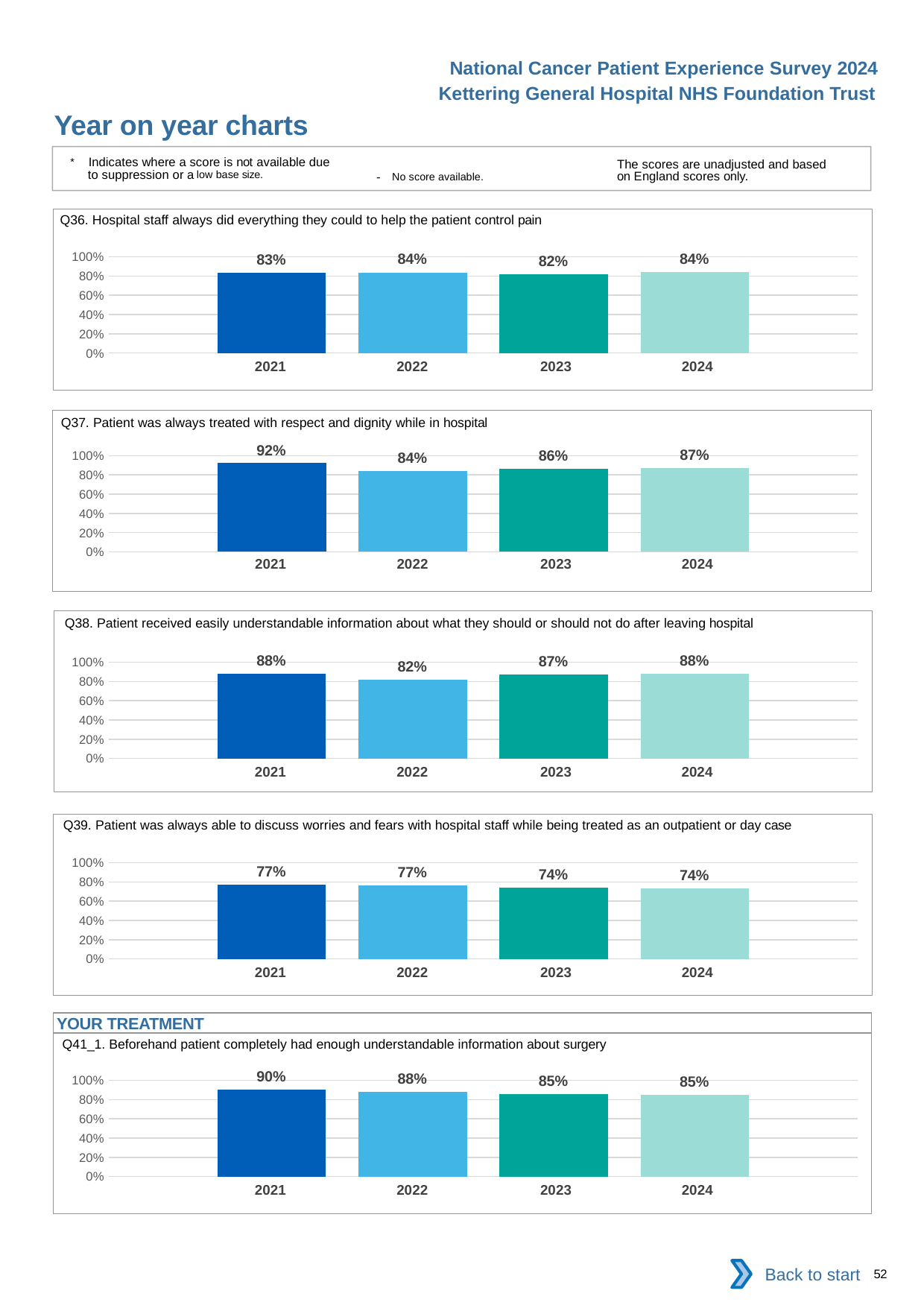
In the Q41_1 chart (Beforehand patient completely had enough understandable information about surgery), which is larger, the value for 2021 or the value for 2022? 2021 What kind of chart is the Q37 chart (Patient was always treated with respect and dignity while in hospital)? bar chart In the Q39 chart (Patient was always able to discuss worries and fears with hospital staff while being treated as an outpatient or day case), what is the value for 2021? 77% In the Q36 chart (Hospital staff always did everything they could to help the patient control pain), what is the value for 2023? 82% In the Q41_1 chart (Beforehand patient completely had enough understandable information about surgery), do the values rise or fall from 2021 to 2024? fall How many years are shown on the x axis of the Q36 chart (Hospital staff always did everything they could to help the patient control pain)? 4 In the Q41_1 chart (Beforehand patient completely had enough understandable information about surgery), what is the difference between the 2021 and 2024 values? 5% In the Q37 chart (Patient was always treated with respect and dignity while in hospital), what is the difference between the 2021 and 2022 values? 8% In the Q38 chart (Patient received easily understandable information about what they should or should not do after leaving hospital), which year has the lowest value? 2022 In the Q38 chart (Patient received easily understandable information about what they should or should not do after leaving hospital), what is the value for 2024? 88% In the Q39 chart (Patient was always able to discuss worries and fears with hospital staff while being treated as an outpatient or day case), is the value for 2024 greater or less than 80%? less In the Q37 chart (Patient was always treated with respect and dignity while in hospital), which year has the highest value? 2021